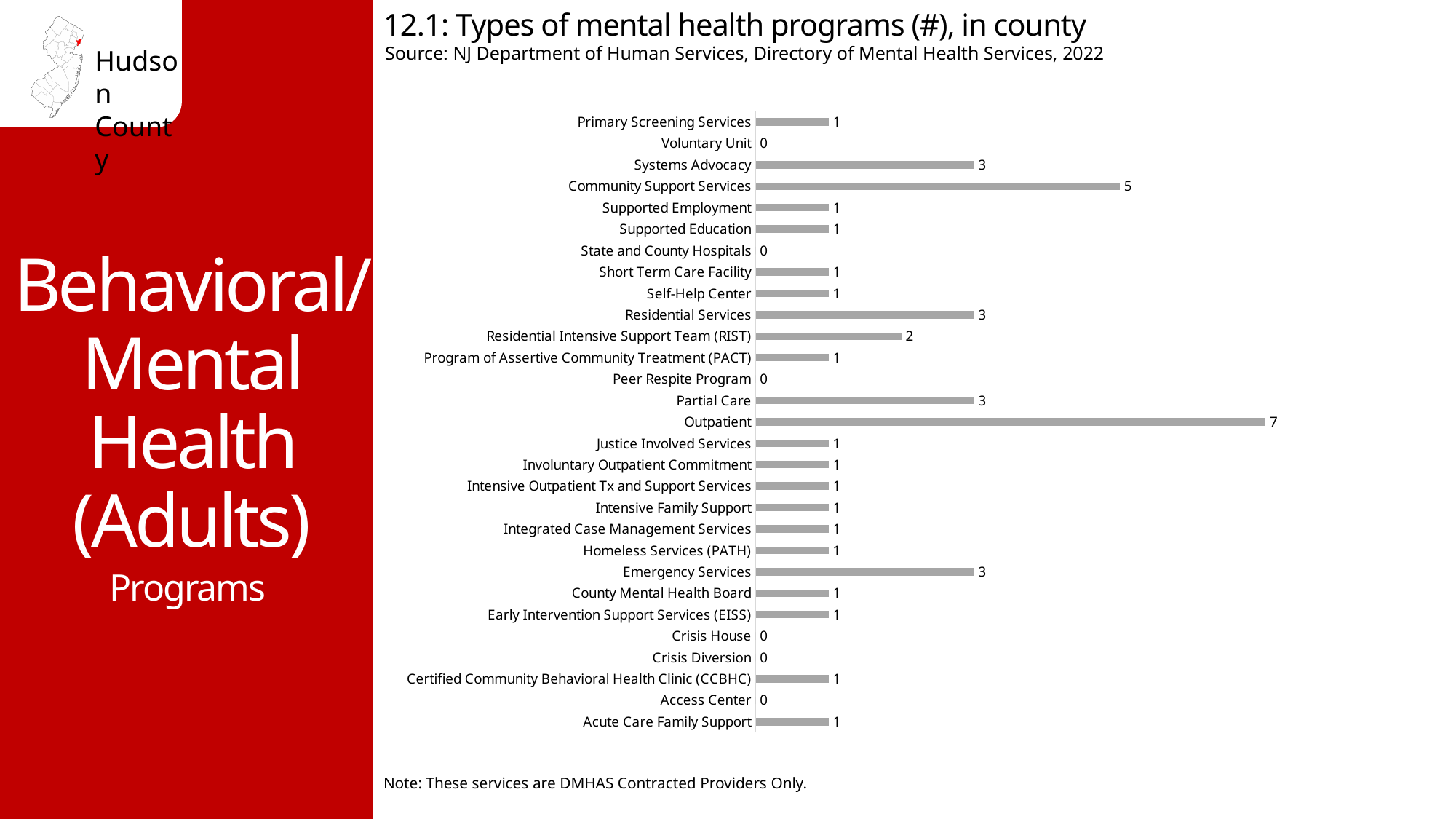
Which is larger, the value for Systems Advocacy or the value for Supported Employment? Systems Advocacy What is the difference between the Outpatient count and the Community Support Services count? 2 What kind of chart is shown on the slide? Bar chart What is the source cited for the chart? NJ Department of Human Services, Directory of Mental Health Services, 2022 Which type of mental health program has the highest count? Outpatient How many Outpatient programs are shown in the chart? 7 What is the value for Emergency Services? 3 What is the value for Crisis House? 0 How many program types have a value of 0? 6 How many program types are listed in the chart? 29 What is the value for Residential Intensive Support Team (RIST)? 2 What is the value for Community Support Services? 5